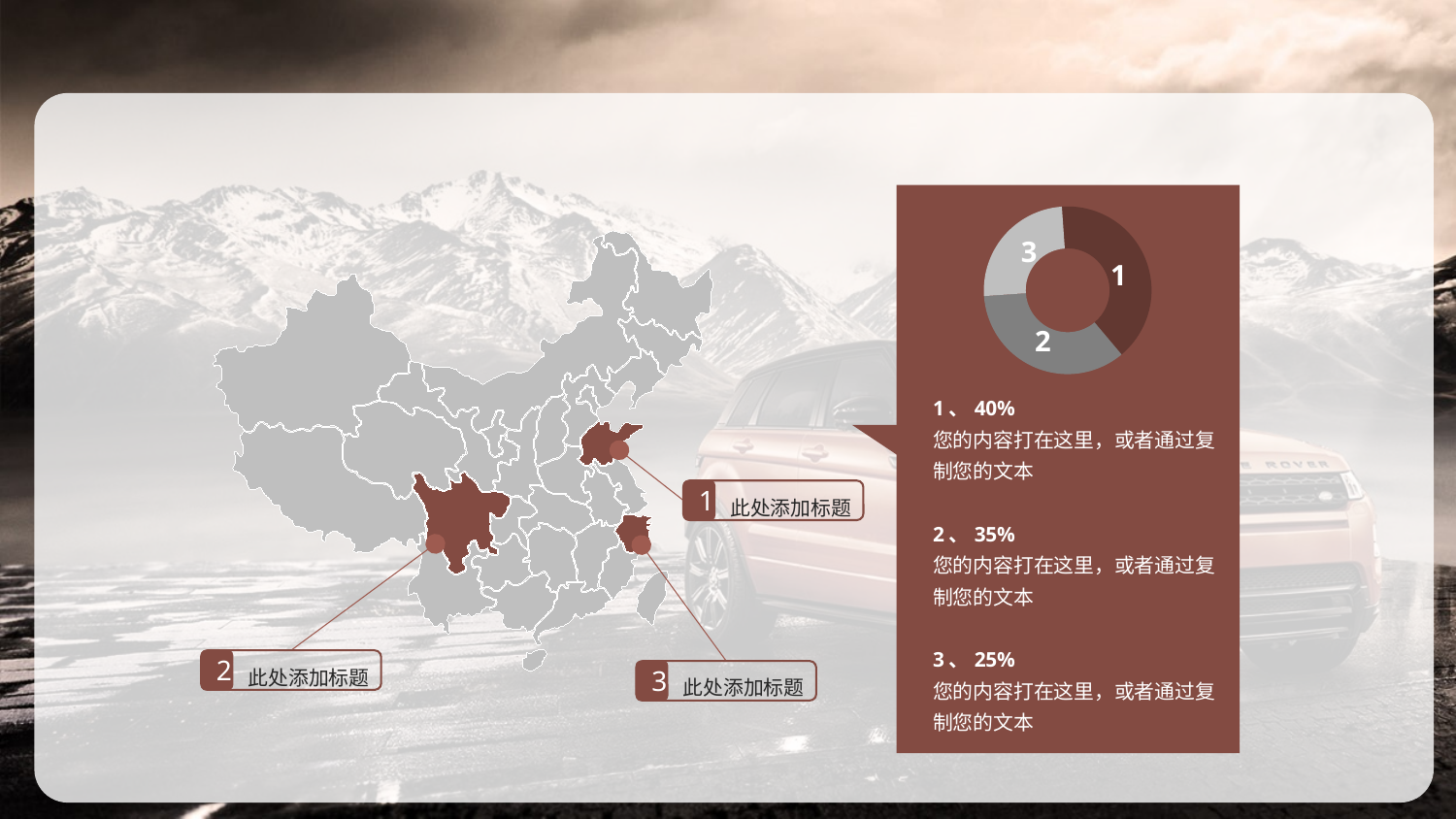
How many segments does the donut chart have? 3 What do the three segment percentages of the donut chart add up to? 100% What percentage is given for segment 1 of the donut chart? 40% What kind of chart is shown on the slide? pie chart (donut) What percentage is given for segment 3 of the donut chart? 25% What is the difference between the percentages for segment 1 and segment 3? 15% What is the difference between the percentages for segment 1 and segment 2? 5% What percentage is given for segment 2 of the donut chart? 35% Which segment of the donut chart has the smallest share? 3 Which segment of the donut chart is drawn in the lightest grey colour? 3 Which segment of the donut chart has the largest share? 1 Which is larger, the share of segment 2 or the share of segment 3? segment 2